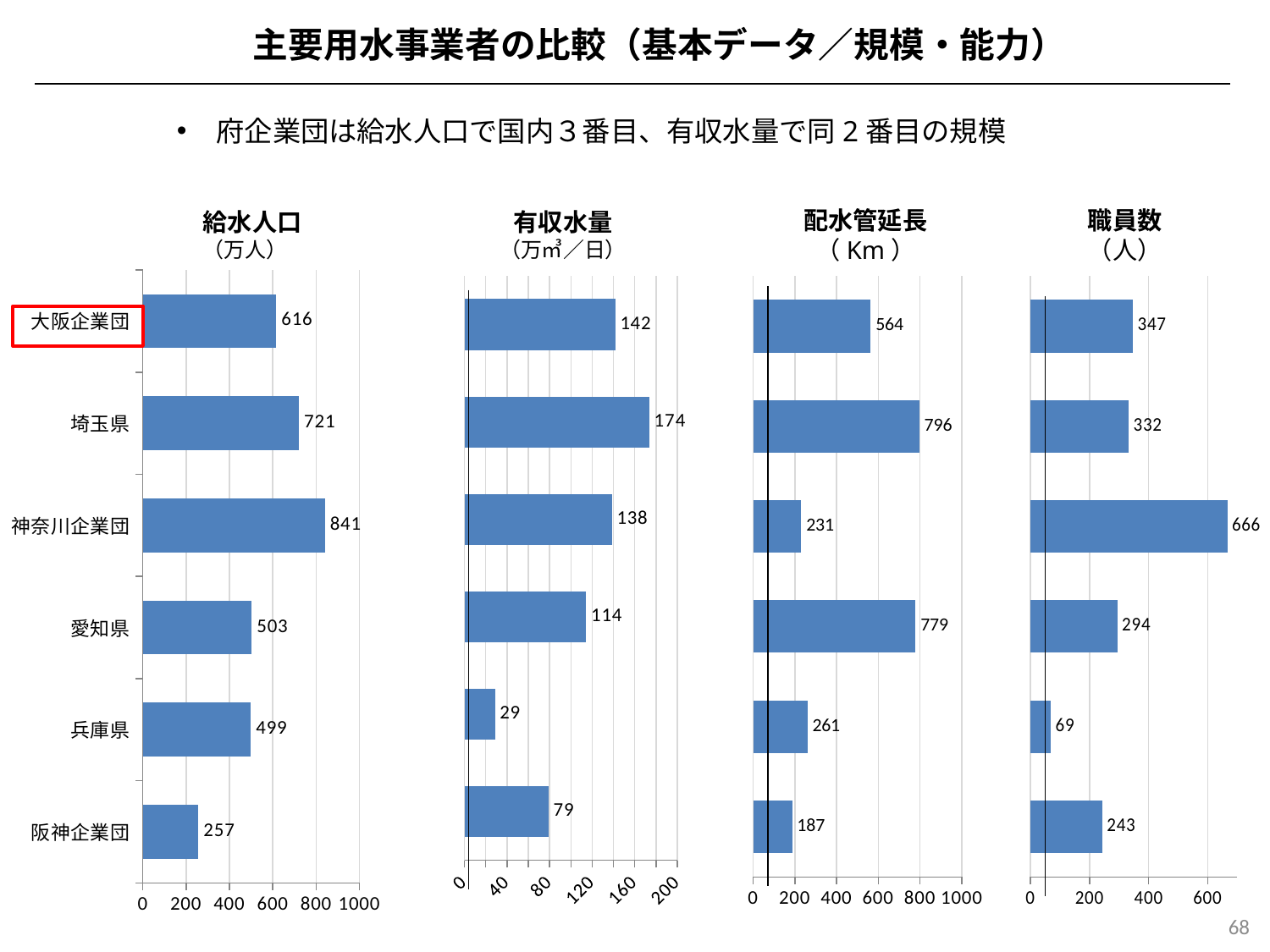
In the 職員数 chart, what is the difference between the values for 大阪企業団 and 埼玉県? 15 How many categories are shown in the 給水人口 chart? 6 In the 配水管延長 chart, what is the difference between the values for 埼玉県 and 愛知県? 17 What kind of chart is the 有収水量 chart? Bar chart In the 職員数 chart, what is the value for 神奈川企業団? 666 In the 給水人口 chart, what is the value for 大阪企業団? 616 In the 配水管延長 chart, which is larger, the value for 大阪企業団 or the value for 神奈川企業団? 大阪企業団 In the 有収水量 chart, what is the value for 埼玉県? 174 In the 職員数 chart, which category has the lowest value? 兵庫県 In the 給水人口 chart, which category has the highest value? 神奈川企業団 What unit is shown under the title of the 配水管延長 chart? Km In the 有収水量 chart, which category has the lowest value? 兵庫県